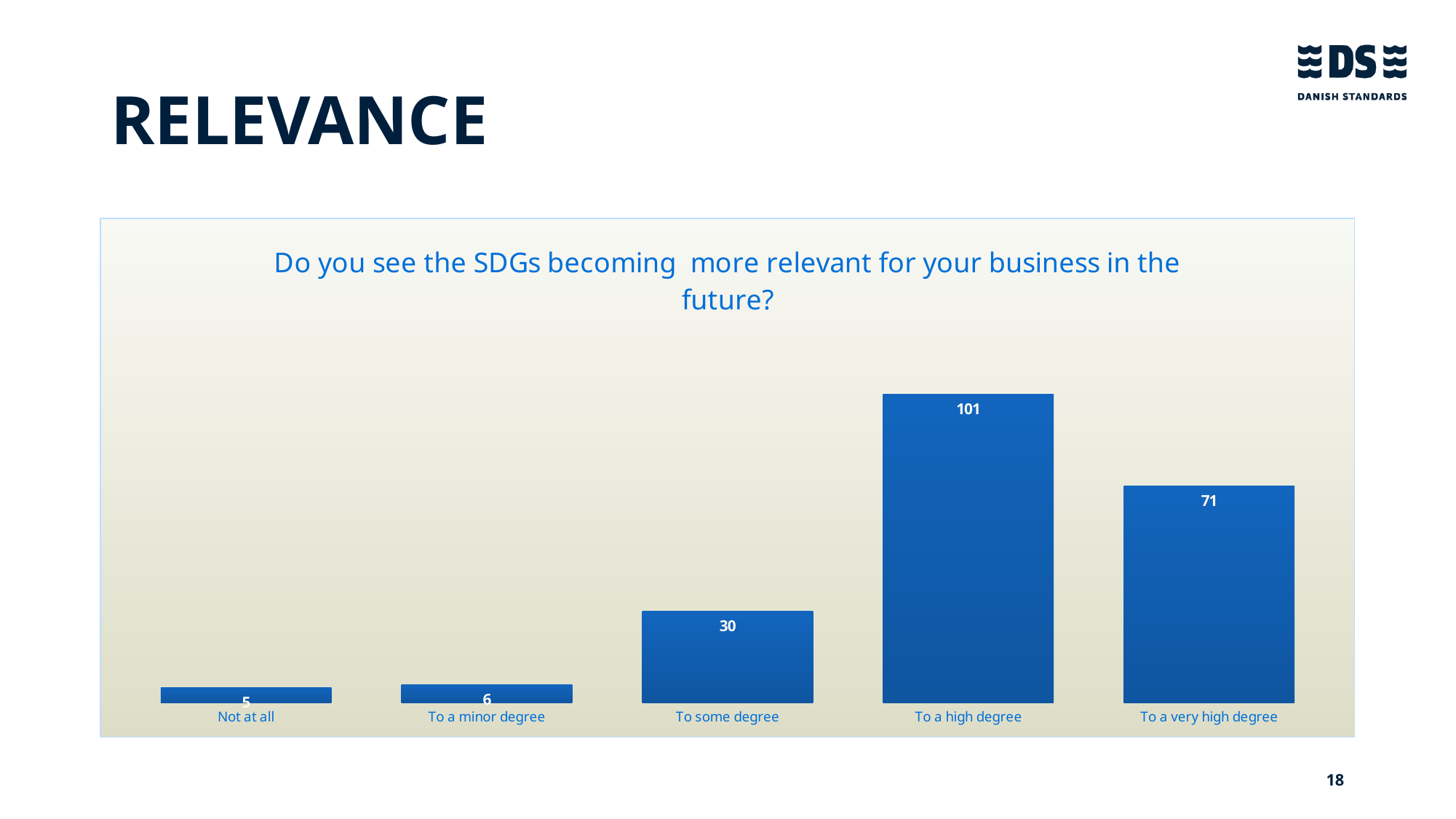
What is the value for "To a very high degree"? 71 What kind of chart is shown on the slide? Bar chart What is the difference between the values for "To a high degree" and "To a very high degree"? 30 Which category has the highest value? To a high degree What is the total of all five values in the chart? 213 Which category has the lowest value? Not at all What is the value for "To a high degree"? 101 Which is larger, the value for "To some degree" or the value for "To a very high degree"? To a very high degree What is the value for "To some degree"? 30 What is the title of the chart? Do you see the SDGs becoming more relevant for your business in the future? What is the value for "Not at all"? 5 How many categories are shown in the chart? 5